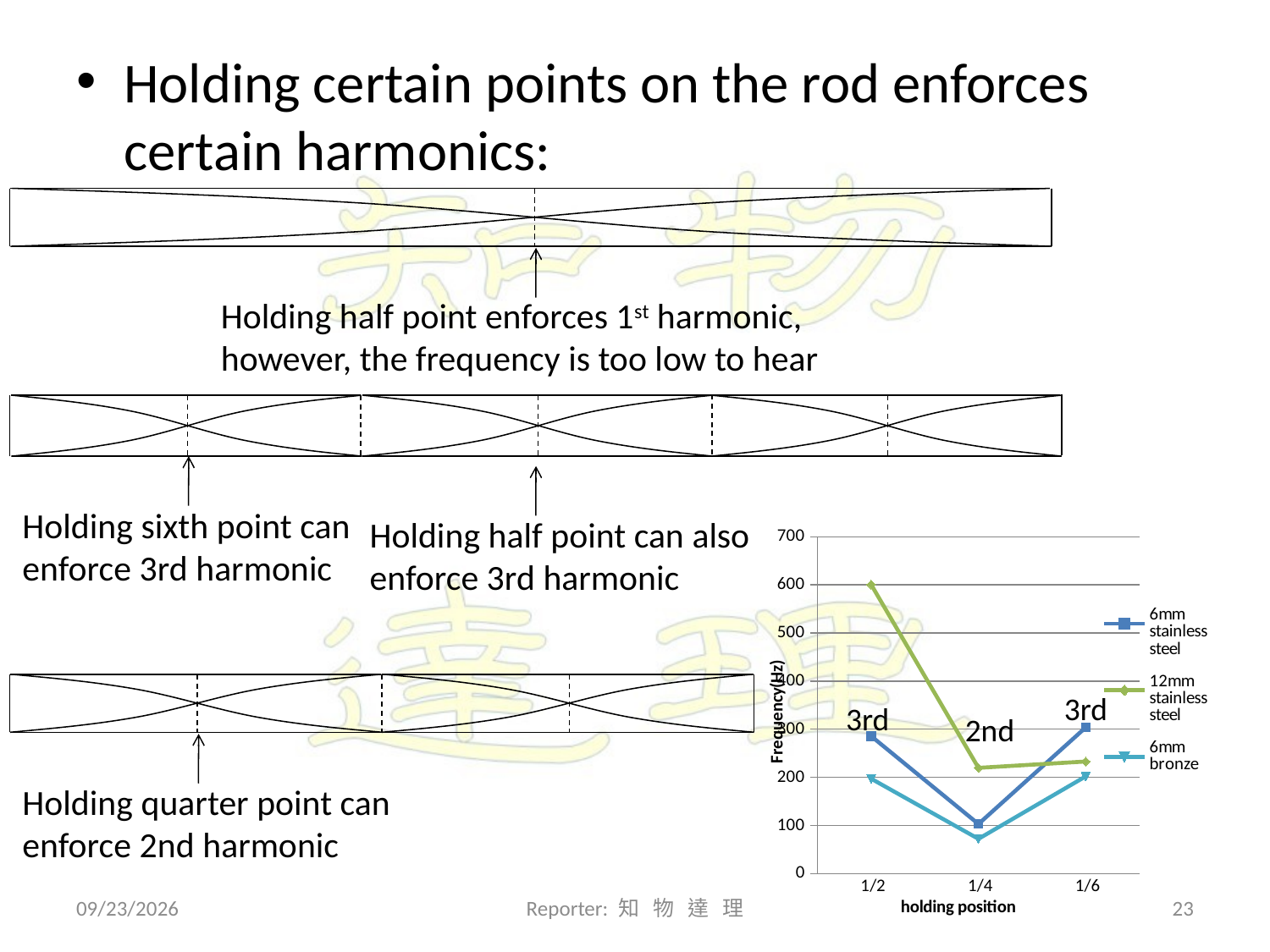
For 12mm stainless steel, does the frequency rise or fall from holding position 1/2 to 1/4? fall How many holding positions are plotted along the x axis of the chart? 3 Is the frequency for 6mm stainless steel at holding position 1/6 greater or less than 200? greater Which series has the highest frequency at holding position 1/2? 12mm stainless steel How many series does the chart's legend list? 3 At holding position 1/2, which is larger: the frequency for 6mm stainless steel or for 6mm bronze? 6mm stainless steel What is the title of the chart's x axis? holding position What kind of chart is shown on the slide? line chart Is the frequency for 6mm bronze at holding position 1/4 greater or less than 100? less Is the frequency for 12mm stainless steel at holding position 1/2 greater or less than 500? greater Which series has the lowest frequency at holding position 1/4? 6mm bronze What is the title of the chart's y axis? Frequency (Hz)